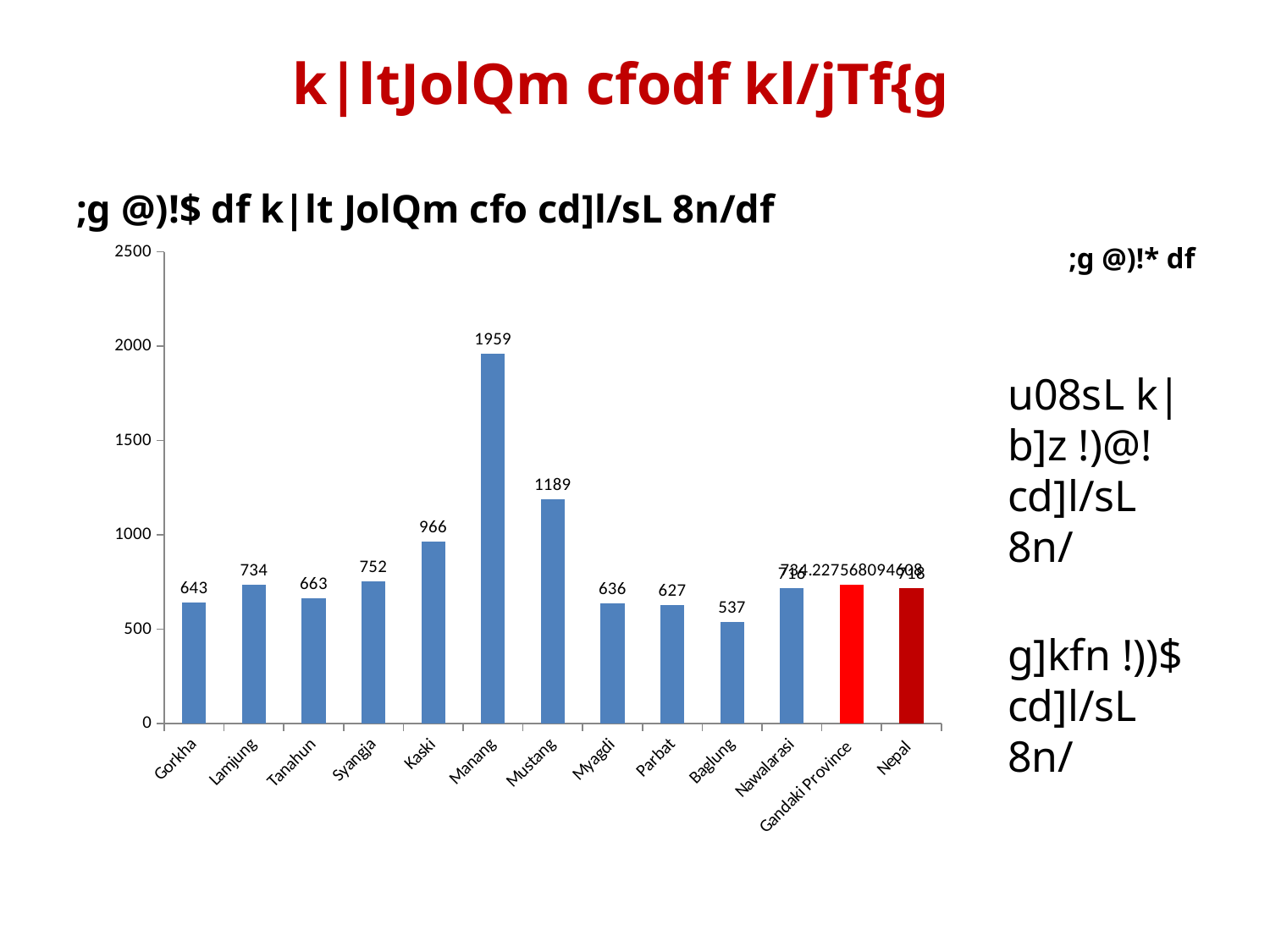
What is the value for Mustang? 1189 Which is larger, the value for Lamjung or the value for Tanahun? Lamjung How many categories are shown on the x axis? 13 What kind of chart is shown on the slide? bar chart What is the difference between the values for Manang and Mustang? 770 Is the value for Gandaki Province greater or less than 1000? less Which category has the lowest value? Baglung What is the value for Kaski? 966 What is the value for Baglung? 537 What is the value for Manang? 1959 What is the difference between the values for Kaski and Gorkha? 323 Which category has the highest value? Manang